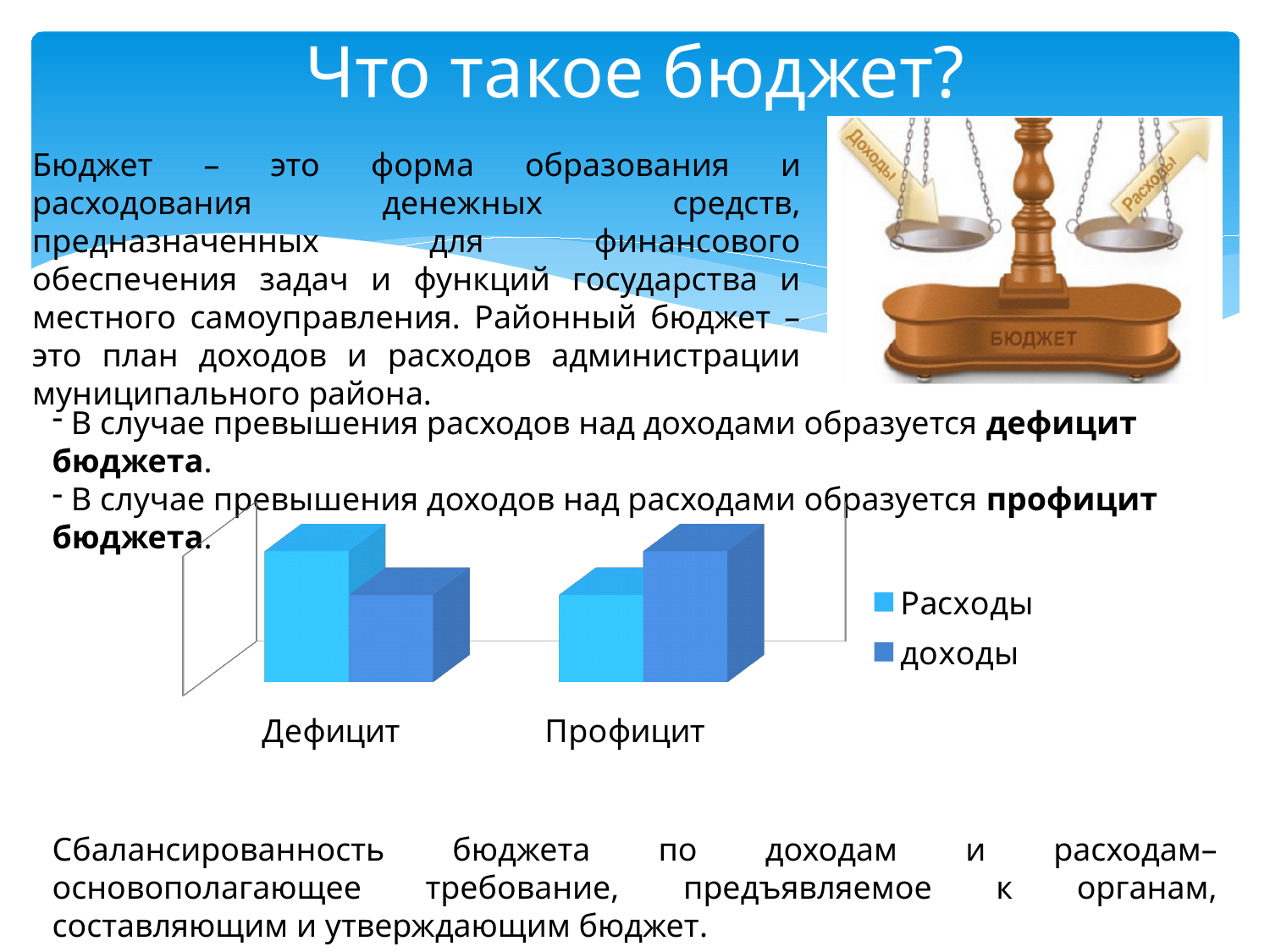
In the Профицит category, which series has the taller bar, Расходы or доходы? доходы In the Дефицит category, which series has the taller bar, Расходы or доходы? Расходы What are the two series listed in the chart's legend? Расходы, доходы For the доходы series, which category has the higher bar, Дефицит or Профицит? Профицит In which category is the Расходы bar the highest? Дефицит What are the two categories on the x axis of the chart? Дефицит, Профицит In which category is the доходы bar the lowest? Дефицит What kind of chart is shown on the slide? bar chart How many categories are shown on the x axis of the chart? 2 How many series does the chart's legend list? 2